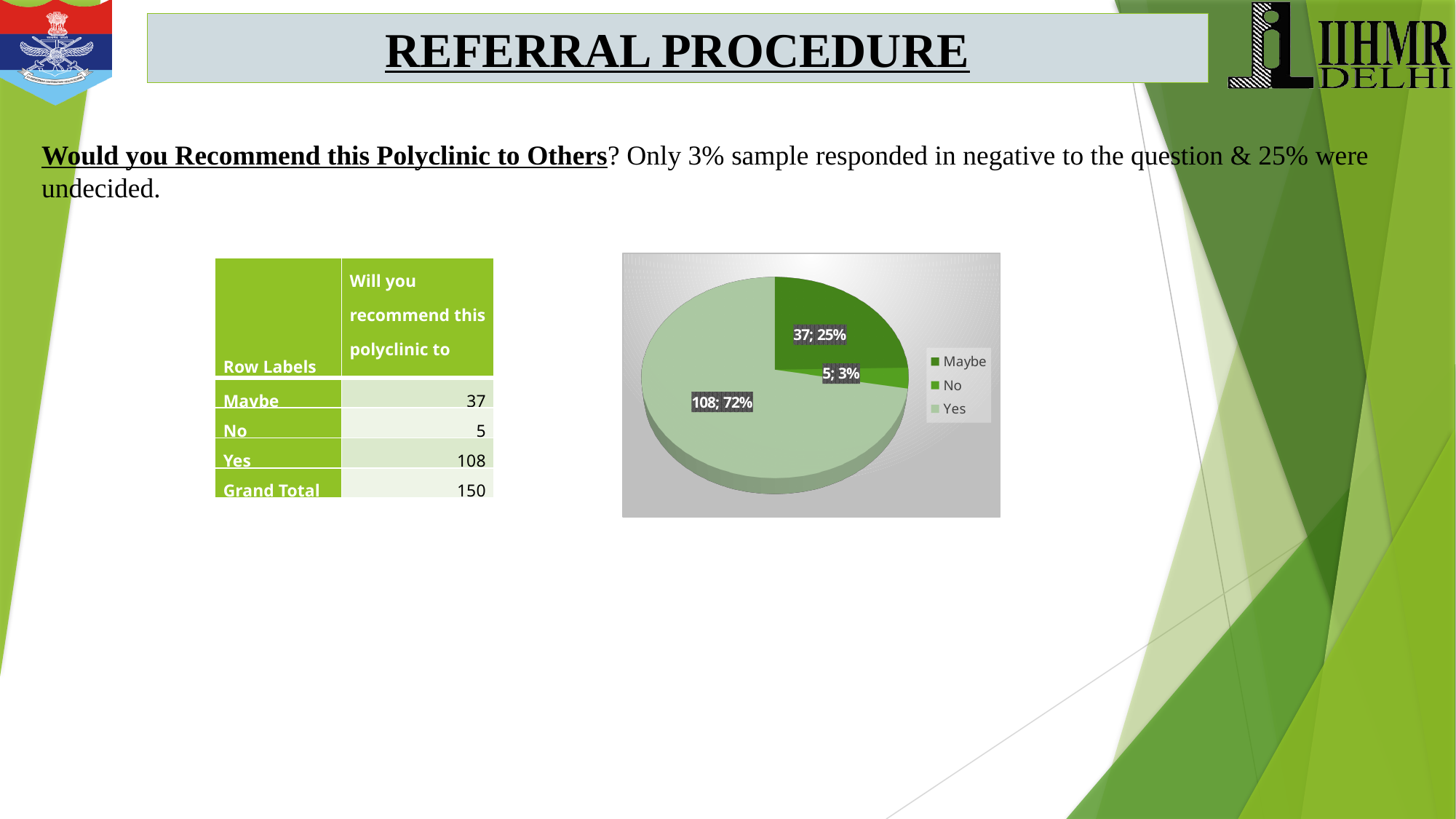
How many slices does the pie chart have? 3 What is the value for the Yes slice in the pie chart? 108 What kind of chart is shown on the slide? pie chart Which is larger in the pie chart, Maybe or No? Maybe Which category has the smallest slice in the pie chart? No What share of the pie does the Yes slice represent? 72% What is the difference between the Yes and Maybe values in the pie chart? 71 What are the legend entries of the pie chart, in order? Maybe, No, Yes What is the value for the Maybe slice in the pie chart? 37 Which category has the largest slice in the pie chart? Yes What share of the pie does the Maybe slice represent? 25% What is the value for the No slice in the pie chart? 5